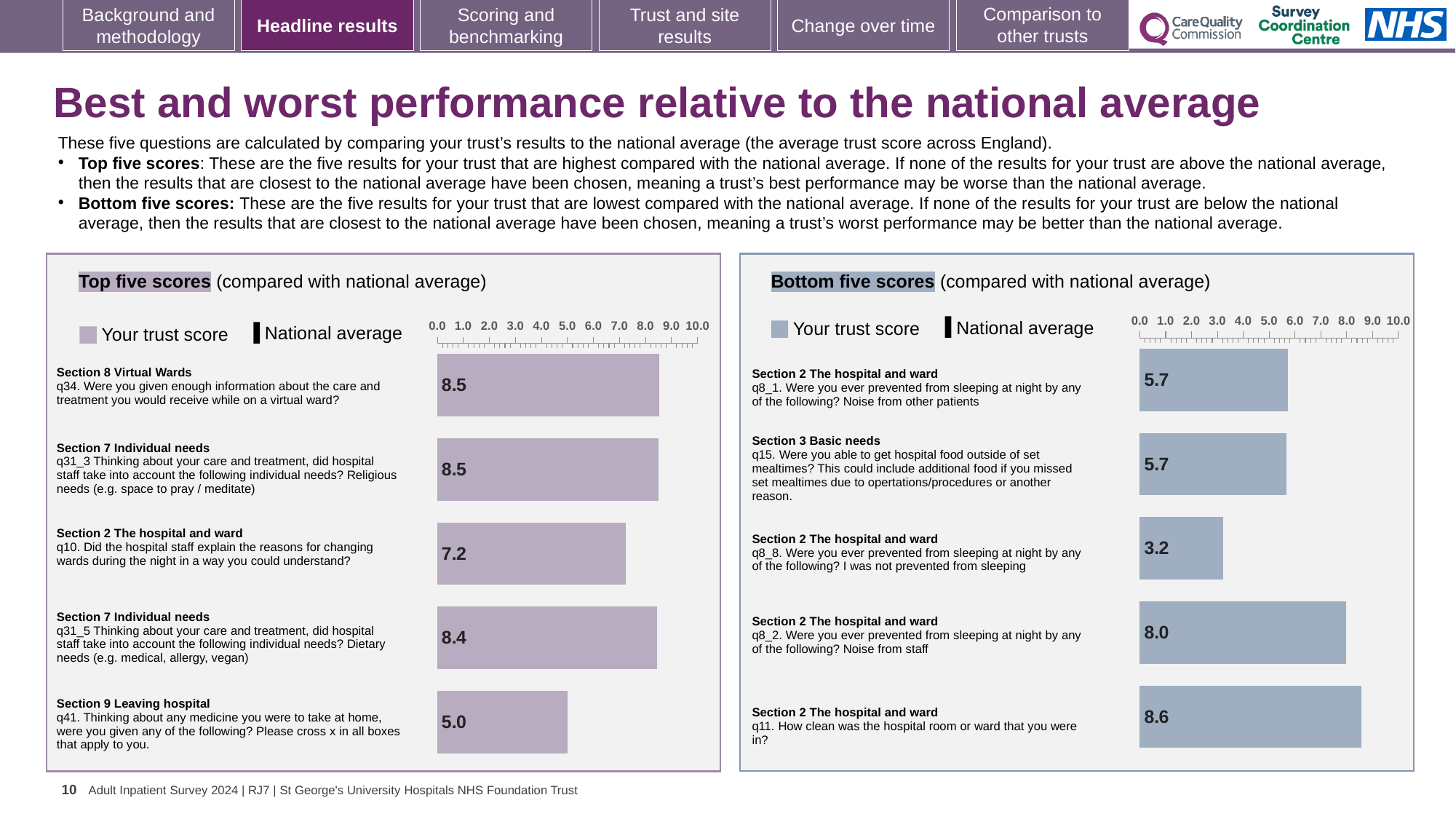
In the Bottom five scores chart, which question has the highest trust score? q11 (How clean was the hospital room or ward) How many bars are plotted in the Top five scores chart? 5 In the Top five scores chart, which has the larger trust score: q10 or q31_5? q31_5 In the Top five scores chart, what is the trust score for q41 (Section 9 Leaving hospital)? 5.0 In the Bottom five scores chart, what is the trust score for q8_8 (I was not prevented from sleeping)? 3.2 In the Bottom five scores chart, which question has the lowest trust score? q8_8 (I was not prevented from sleeping) In the Bottom five scores chart, what is the difference between the trust scores for q11 and q8_8? 5.4 In the Top five scores chart, which question has the lowest trust score? q41 (Section 9 Leaving hospital) What type of chart is used for the Bottom five scores? Bar chart In the Top five scores chart, what is the trust score for q34 (Section 8 Virtual Wards)? 8.5 In the Top five scores chart, what is the difference between the trust scores for q31_5 and q41? 3.4 In the Bottom five scores chart, which has the larger trust score: q8_2 (Noise from staff) or q8_1 (Noise from other patients)? q8_2 (Noise from staff)